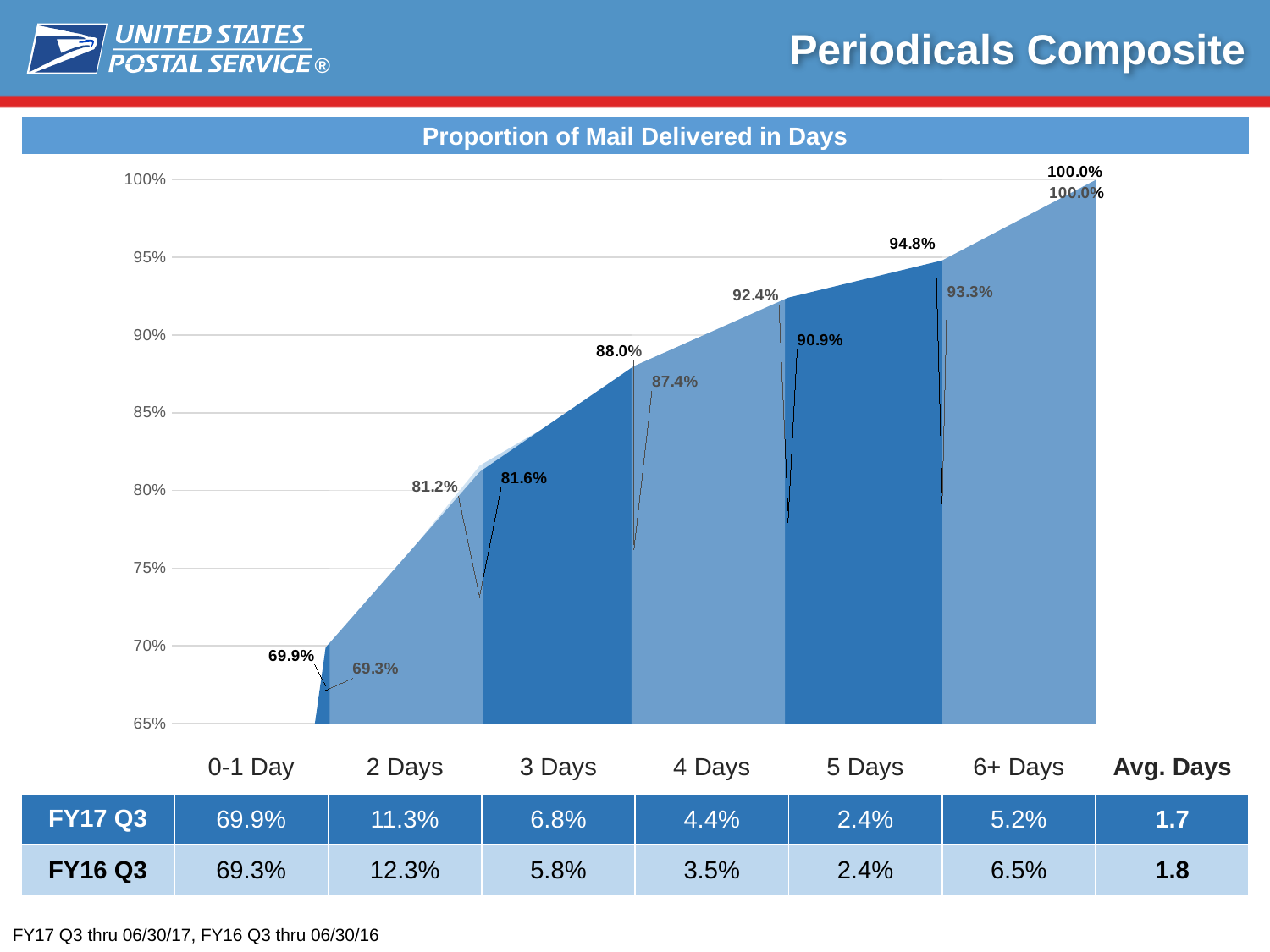
Do the cumulative proportions rise or fall as the day categories increase along the x axis? rise What is the lowest value shown on the y axis of the chart? 65% What is the difference between the FY17 Q3 and FY16 Q3 cumulative proportions at 5 Days? 1.5% At 2 Days, which series has the higher cumulative proportion, FY17 Q3 or FY16 Q3? FY16 Q3 How many day categories are shown along the x axis of the chart? 6 Which day category has the lowest cumulative proportion for FY17 Q3? 0-1 Day What is the cumulative proportion of mail delivered within 4 days for FY17 Q3, as labeled on the chart? 92.4% What is the title of the chart? Proportion of Mail Delivered in Days What is the cumulative proportion of mail delivered within 5 days for FY16 Q3, as labeled on the chart? 93.3% What is the cumulative proportion of mail delivered within 3 days for FY17 Q3, as labeled on the chart? 88.0% Is the FY17 Q3 cumulative proportion at 3 Days greater or less than 85%? greater What type of chart is shown on the slide? area chart